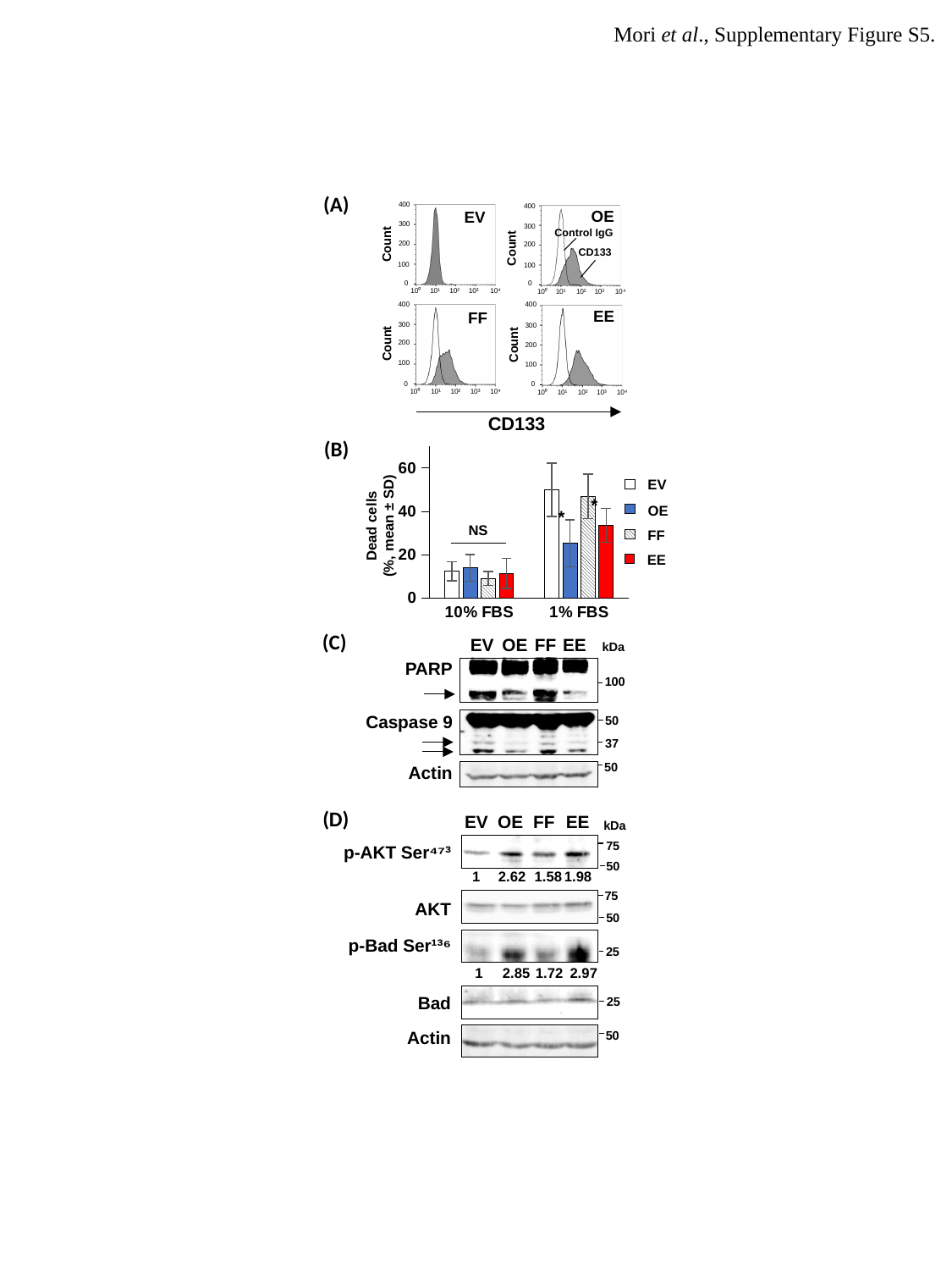
In panel (B), which is larger: the EV value at 10% FBS or the EV value at 1% FBS? EV at 1% FBS In panel (A), how many histogram plots are shown? 4 In panel (B), which series has the lowest value at 1% FBS? OE In panel (B), how many categories are shown on the x axis? 2 In panel (B), what is the label of the y axis? Dead cells (%, mean ± SD) In panel (B), is the value for EV at 1% FBS greater or less than 40? greater In panel (B), which series is shown in red in the legend? EE In panel (B), is the value for EE at 10% FBS greater or less than 20? less In panel (B), do the dead cell values rise or fall going from 10% FBS to 1% FBS? rise In panel (B), how many series does the legend list? 4 In panel (B), what kind of chart is shown? bar chart In panel (B), is the value for OE at 1% FBS greater or less than 40? less